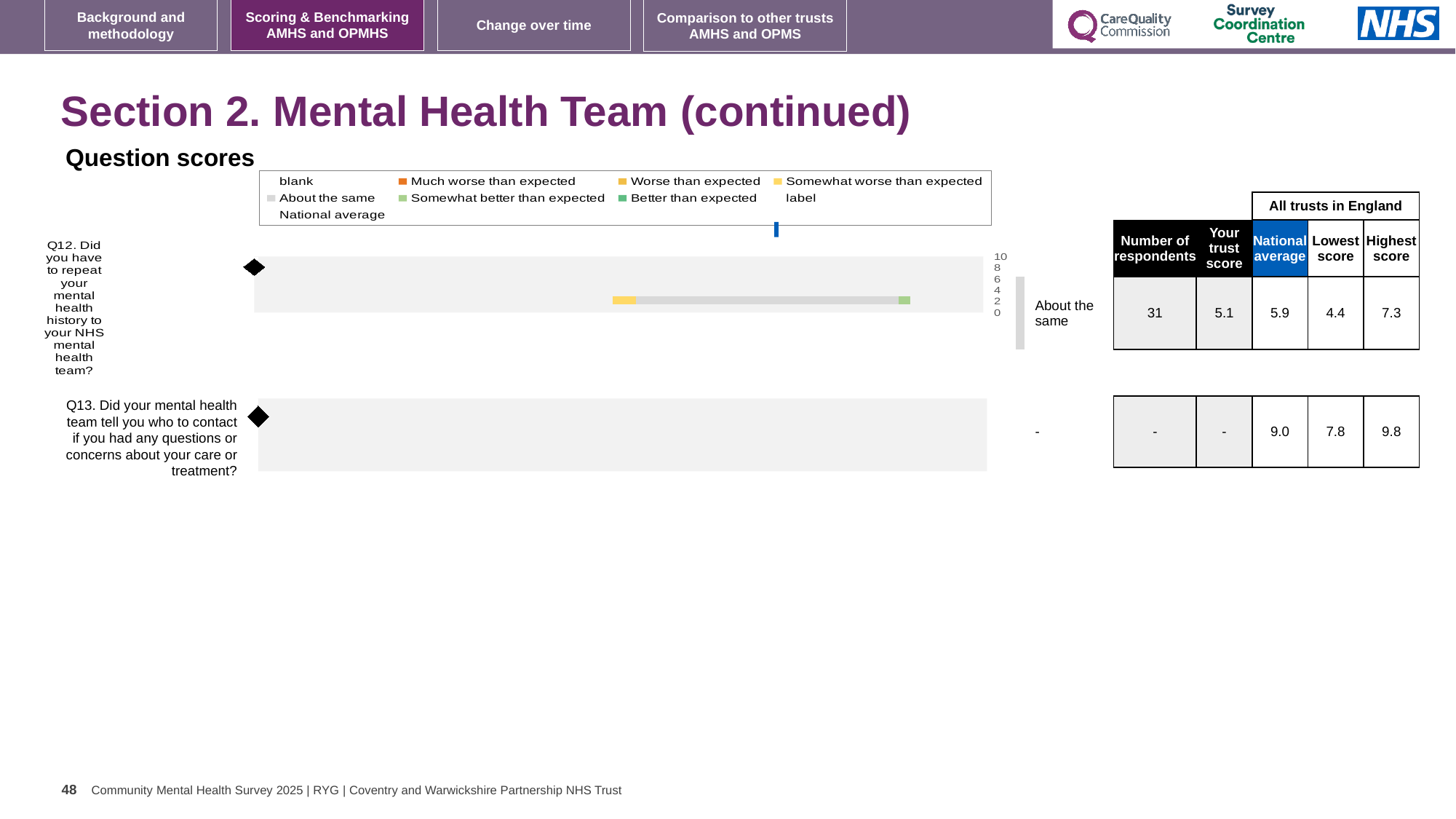
What is the national average score for Q13 (Did your mental health team tell you who to contact if you had any questions or concerns about your care or treatment?)? 9.0 What is the lowest score among all trusts in England for Q12? 4.4 What is the heading above the chart? Question scores How many questions are plotted on the chart? 2 What is the difference between the highest and lowest scores for Q12 across all trusts in England? 2.9 What is the difference between the highest and lowest scores for Q13 across all trusts in England? 2.0 How many respondents answered Q12? 31 What is the highest score among all trusts in England for Q13? 9.8 What is the national average score for Q12? 5.9 What benchmark rating is shown for Q12? About the same What is the trust's score for Q12 (Did you have to repeat your mental health history to your NHS mental health team?)? 5.1 For Q12, which is larger: the trust's score or the national average? National average